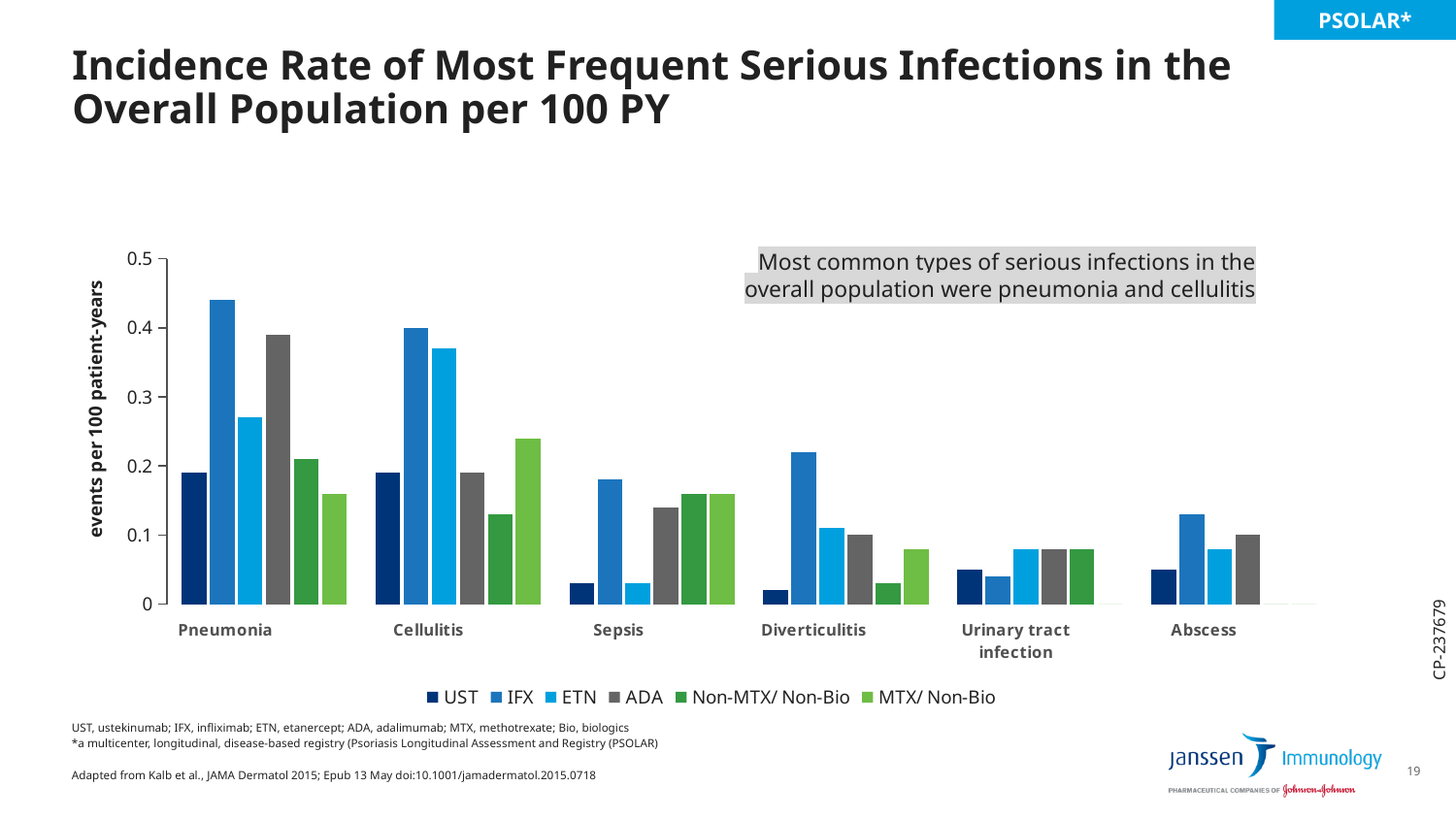
Is the value for ETN in the Cellulitis category greater or less than 0.3? greater In the Cellulitis category, which is larger: IFX or Non-MTX/ Non-Bio? IFX How many infection categories are shown on the x axis? 6 Is the value for ADA in the Pneumonia category greater or less than 0.3? greater Is the value for IFX in the Diverticulitis category greater or less than 0.2? greater Which series has the highest value in the Pneumonia category? IFX Which series has the highest value in the Diverticulitis category? IFX In the Pneumonia category, which is larger: IFX or ETN? IFX What kind of chart is shown on the slide? bar chart How many series does the legend list? 6 What is the label of the y axis? events per 100 patient-years